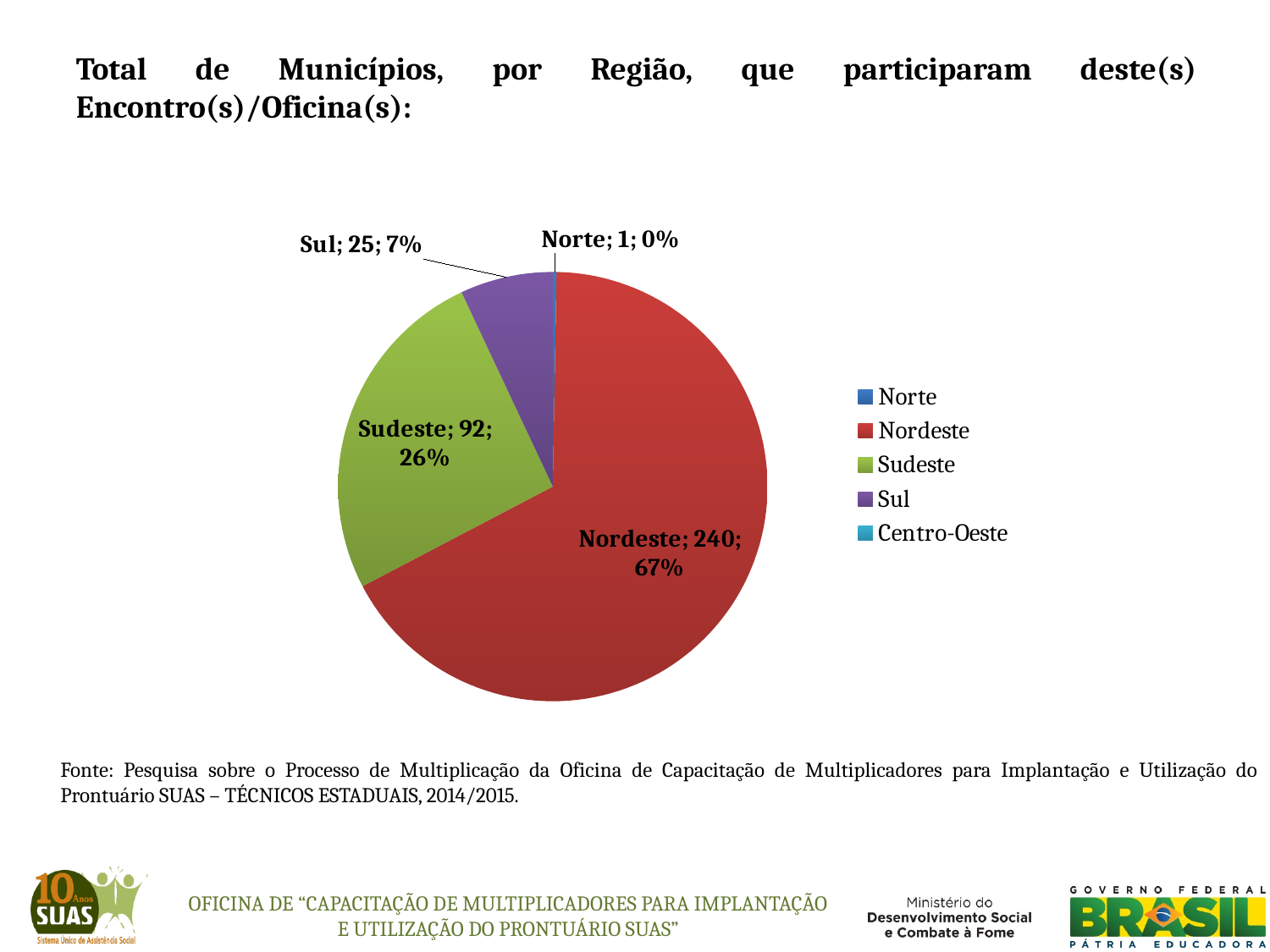
How many municipalities are shown for the Nordeste region? 240 How many municipalities are shown for the Norte region? 1 What share of the pie does the Sudeste slice represent? 26% How many municipalities are shown for the Sul region? 25 What type of chart is shown on the slide? pie chart Which of the labeled regions has the smallest value? Norte Which region has the largest slice of the pie? Nordeste How many municipalities are shown for the Sudeste region? 92 What share of the pie does the Nordeste slice represent? 67% Which is larger, the value for Sudeste or the value for Sul? Sudeste How many entries does the legend list? 5 What is the difference between the Nordeste and Sudeste values? 148